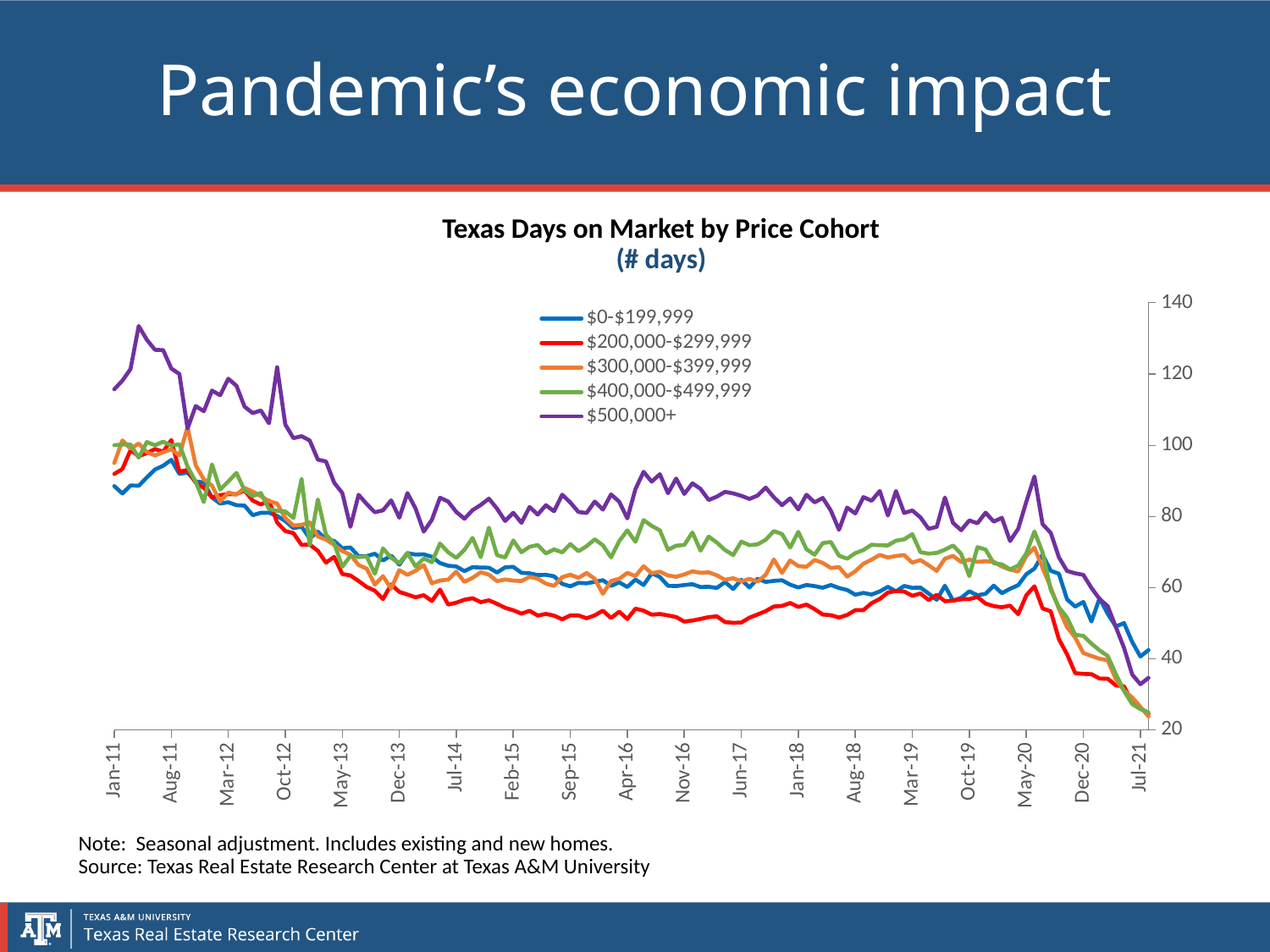
Which price cohort has the highest days on market in Jan-11? $500,000+ What is the title of the chart? Texas Days on Market by Price Cohort (# days) What kind of chart is shown on the slide? line chart Is the peak value of the $500,000+ series in 2011 greater or less than 120? greater Is the value for $400,000-$499,999 at Jul-21 greater or less than 40? less Which price cohort has the lowest days on market around Nov-16? $200,000-$299,999 Does the $200,000-$299,999 series rise or fall overall from Jan-11 to Jul-21? fall How many series does the legend list? 5 Is the value for $200,000-$299,999 around Jun-17 greater or less than 60? less Which colour is used for the $500,000+ series? purple Which is larger around Jan-18, the value for $500,000+ or the value for $0-$199,999? $500,000+